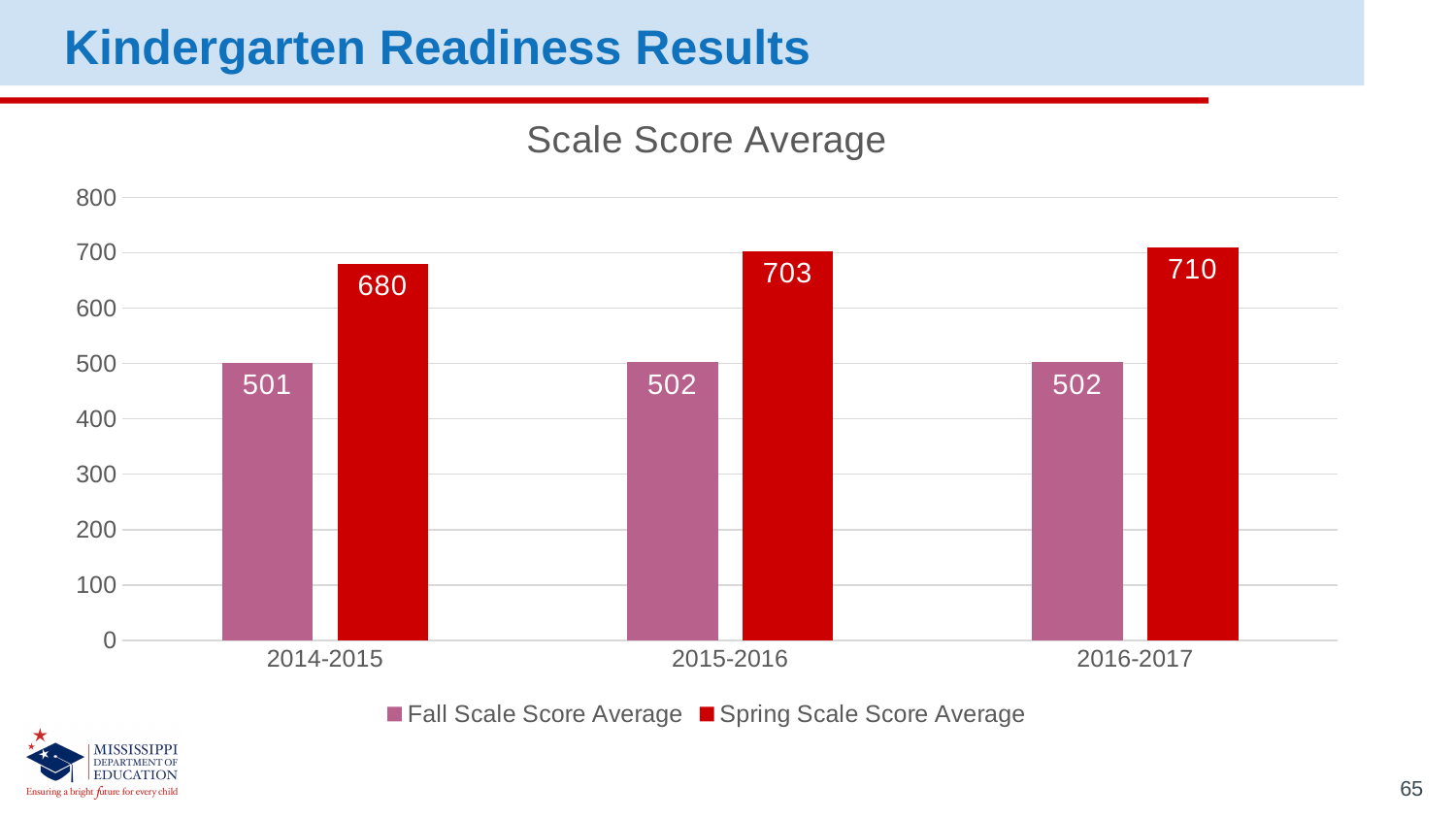
What is the difference between the Spring Scale Score Average for 2016-2017 and for 2014-2015? 30 What kind of chart is shown on the slide? Bar chart What is the Fall Scale Score Average for 2014-2015? 501 Does the Spring Scale Score Average rise or fall from 2014-2015 to 2016-2017? Rise How many series does the legend list? 2 Which is larger, the Fall Scale Score Average for 2015-2016 or the Spring Scale Score Average for 2015-2016? Spring Scale Score Average What is the Spring Scale Score Average for 2016-2017? 710 What is the Spring Scale Score Average for 2015-2016? 703 What is the difference between the Spring and Fall Scale Score Averages for 2014-2015? 179 Which school year has the highest Spring Scale Score Average? 2016-2017 How many school years are shown on the x axis? 3 Which school year has the lowest Spring Scale Score Average? 2014-2015